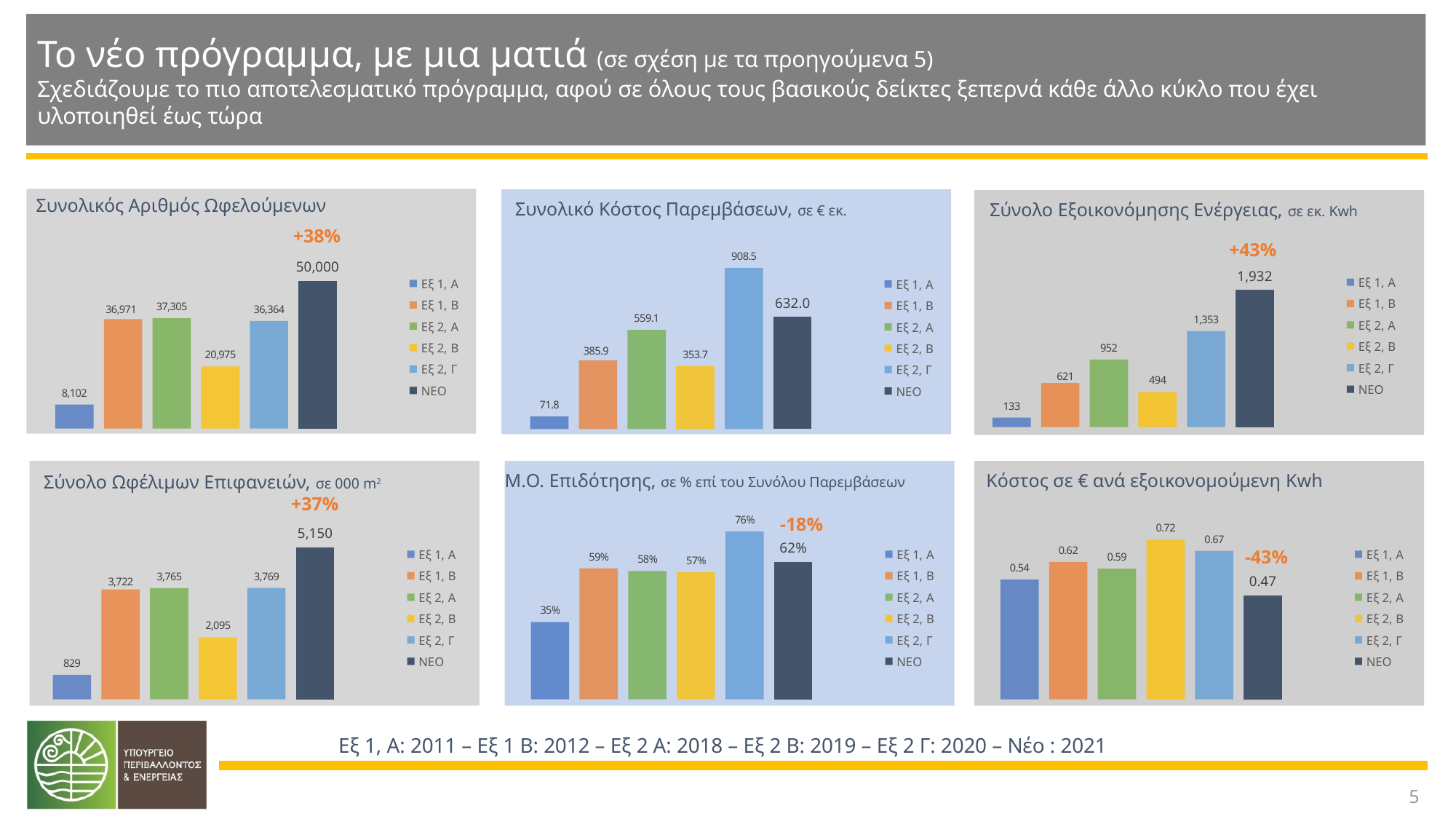
In the chart 'Σύνολο Ωφέλιμων Επιφανειών', which category has the lowest value? Εξ 1, Α In the chart 'Συνολικός Αριθμός Ωφελούμενων', what is the difference between the values for ΝΕΟ and Εξ 2, Γ? 13,636 In the chart 'Συνολικός Αριθμός Ωφελούμενων', what is the value for ΝΕΟ? 50,000 In the chart 'Σύνολο Εξοικονόμησης Ενέργειας', what is the value for Εξ 2, Α? 952 How many series does the legend of the chart 'Μ.Ο. Επιδότησης' list? 6 In the chart 'Σύνολο Εξοικονόμησης Ενέργειας', what is the difference between the values for ΝΕΟ and Εξ 2, Γ? 579 In the chart 'Μ.Ο. Επιδότησης', what is the value for Εξ 2, Γ? 76% In the chart 'Κόστος σε € ανά εξοικονομούμενη Kwh', which category has the highest value? Εξ 2, Β In the chart 'Συνολικό Κόστος Παρεμβάσεων', which is larger, the value for Εξ 2, Α or the value for ΝΕΟ? ΝΕΟ How many bars are plotted in the chart 'Κόστος σε € ανά εξοικονομούμενη Kwh'? 6 In the chart 'Συνολικό Κόστος Παρεμβάσεων', which category has the highest value? Εξ 2, Γ What kind of chart is 'Σύνολο Ωφέλιμων Επιφανειών'? Bar chart